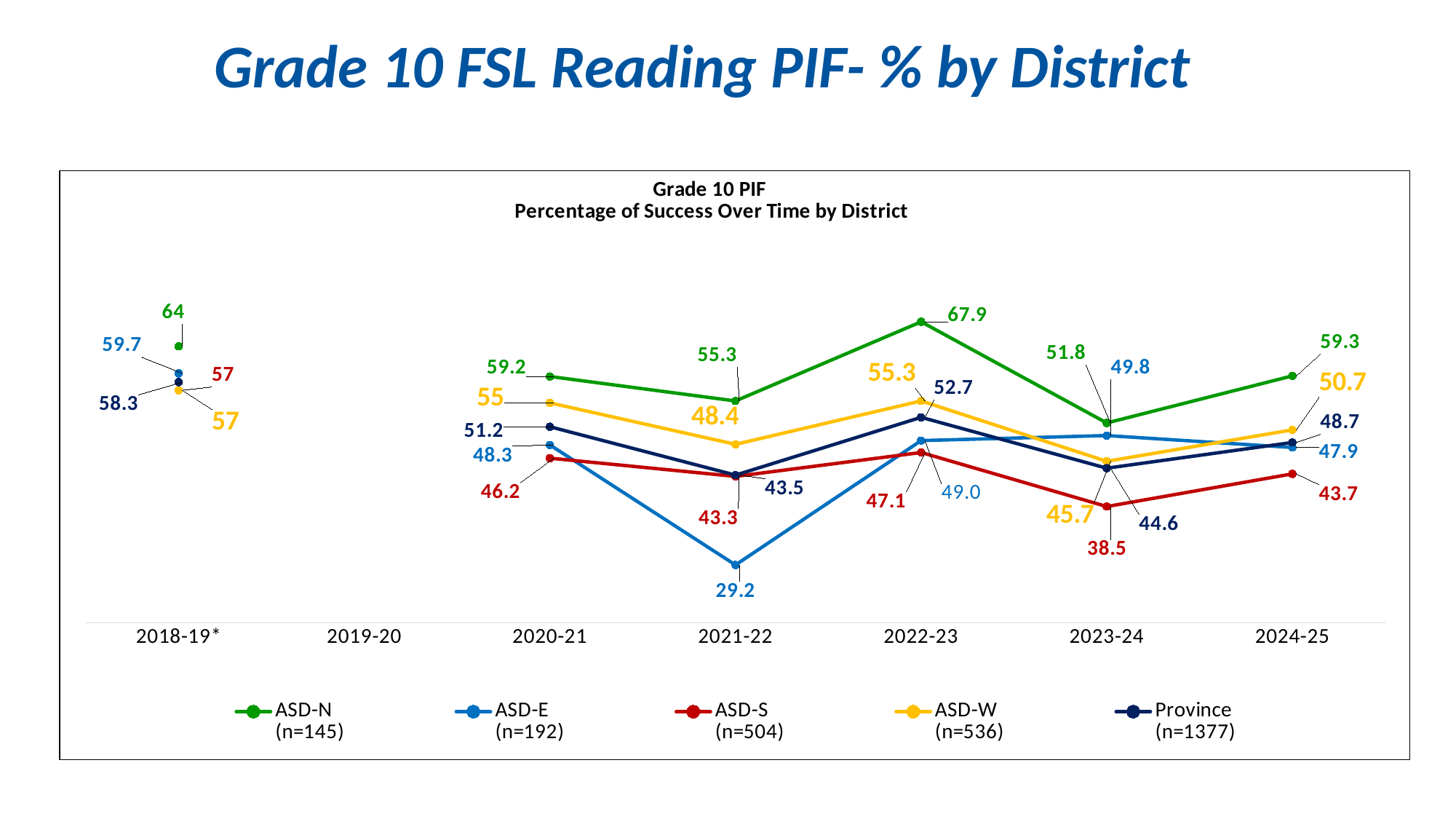
Which is larger in 2023-24, the ASD-W value or the Province value? ASD-W What is the ASD-N value for 2022-23? 67.9 Which district has the highest value in 2022-23? ASD-N What kind of chart is shown? Line chart Did the ASD-E value rise or fall from 2020-21 to 2021-22? Fall What is the ASD-S value for 2023-24? 38.5 What is the Province value for 2024-25? 48.7 How many year categories are shown on the x axis? 7 What is the difference between the ASD-N and ASD-S values in 2024-25? 15.6 Which series has the lowest value in 2021-22? ASD-E How many series does the legend list? 5 What is the ASD-E value for 2021-22? 29.2